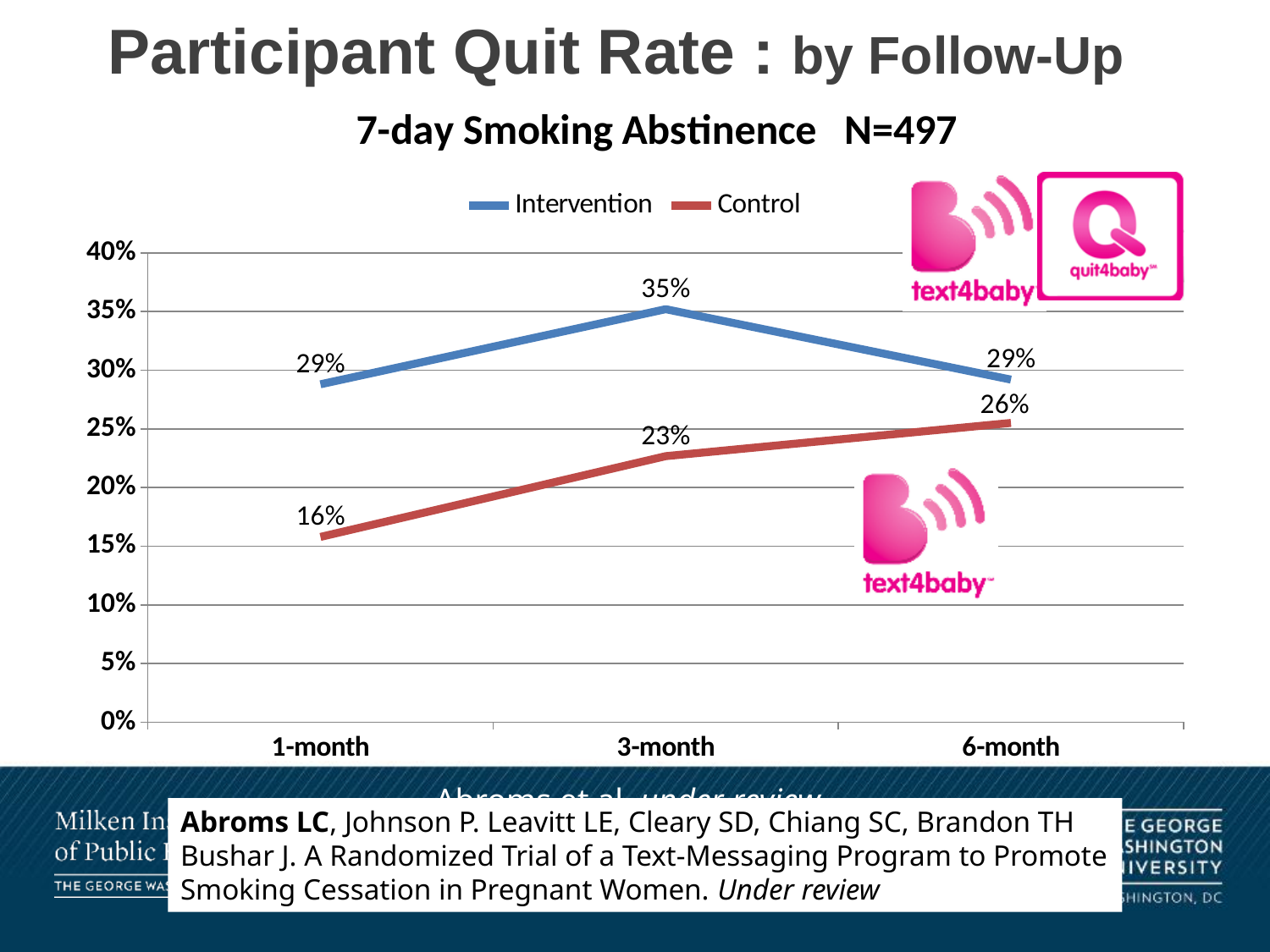
Which group has the higher quit rate at 6-month follow-up, Intervention or Control? Intervention What is the Control quit rate at 1-month follow-up? 16% What is the Intervention quit rate at 3-month follow-up? 35% What is the Control quit rate at 6-month follow-up? 26% At which follow-up point is the Intervention quit rate highest? 3-month At which follow-up point is the Control quit rate lowest? 1-month What kind of chart is shown on the slide? Line chart How many series does the legend list? 2 What is the Intervention quit rate at 1-month follow-up? 29% How many follow-up time points are shown on the x axis? 3 What is the difference between the Intervention and Control quit rates at 3-month follow-up? 12% Does the Control quit rate rise or fall from 1-month to 6-month follow-up? Rise